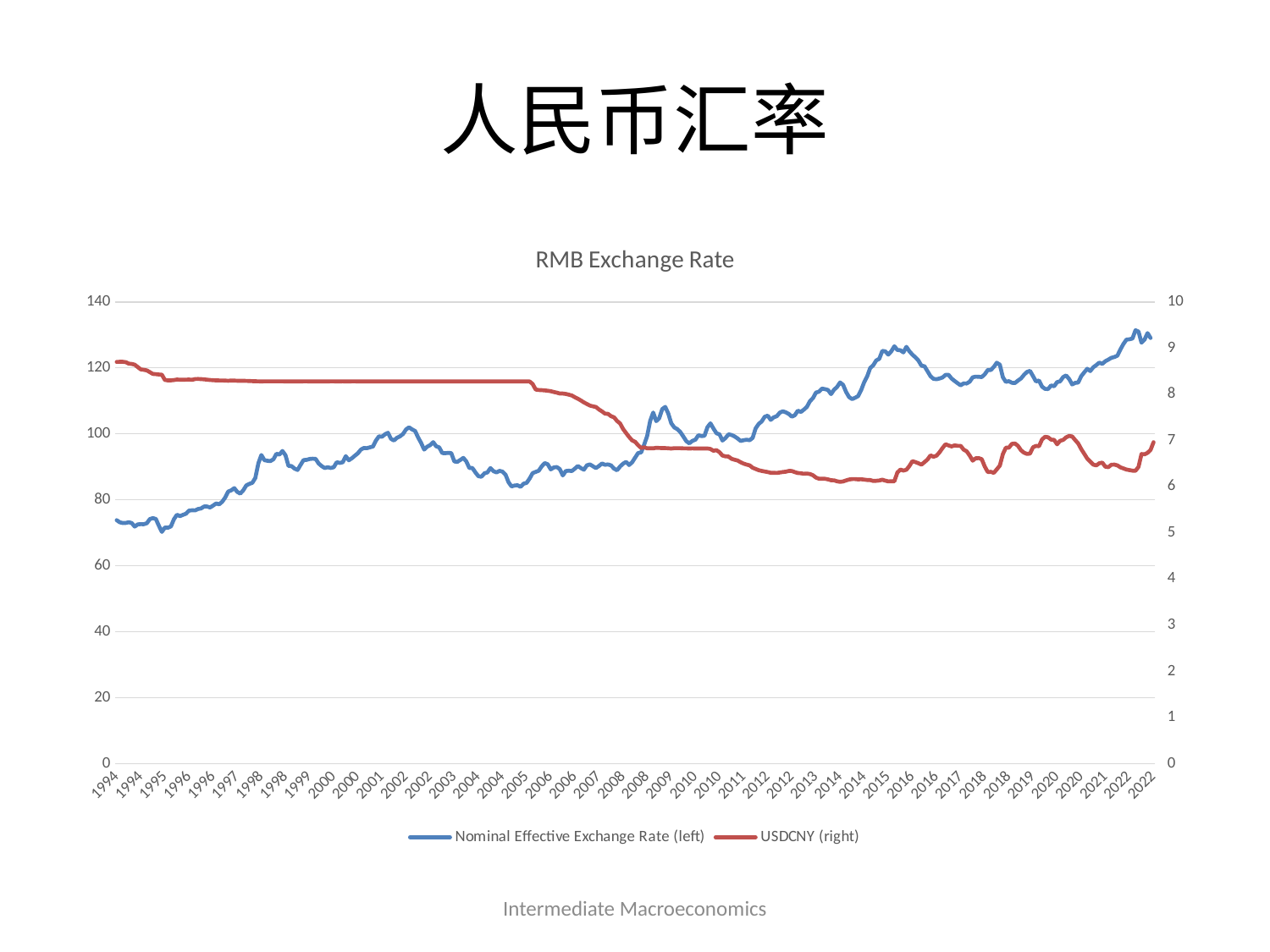
What is the title of the chart? RMB Exchange Rate Is the USDCNY value in 2014 greater or less than 7? less Is the Nominal Effective Exchange Rate at the end of 2022 greater or less than 120? greater Which colour is used for the USDCNY (right) series? red Is the Nominal Effective Exchange Rate in 2005 greater or less than 100? less How many series does the legend list? 2 Does the USDCNY series rise or fall between 2005 and 2014? fall Does the Nominal Effective Exchange Rate overall rise or fall from 1994 to 2022? rise What kind of chart is shown on the slide? line chart